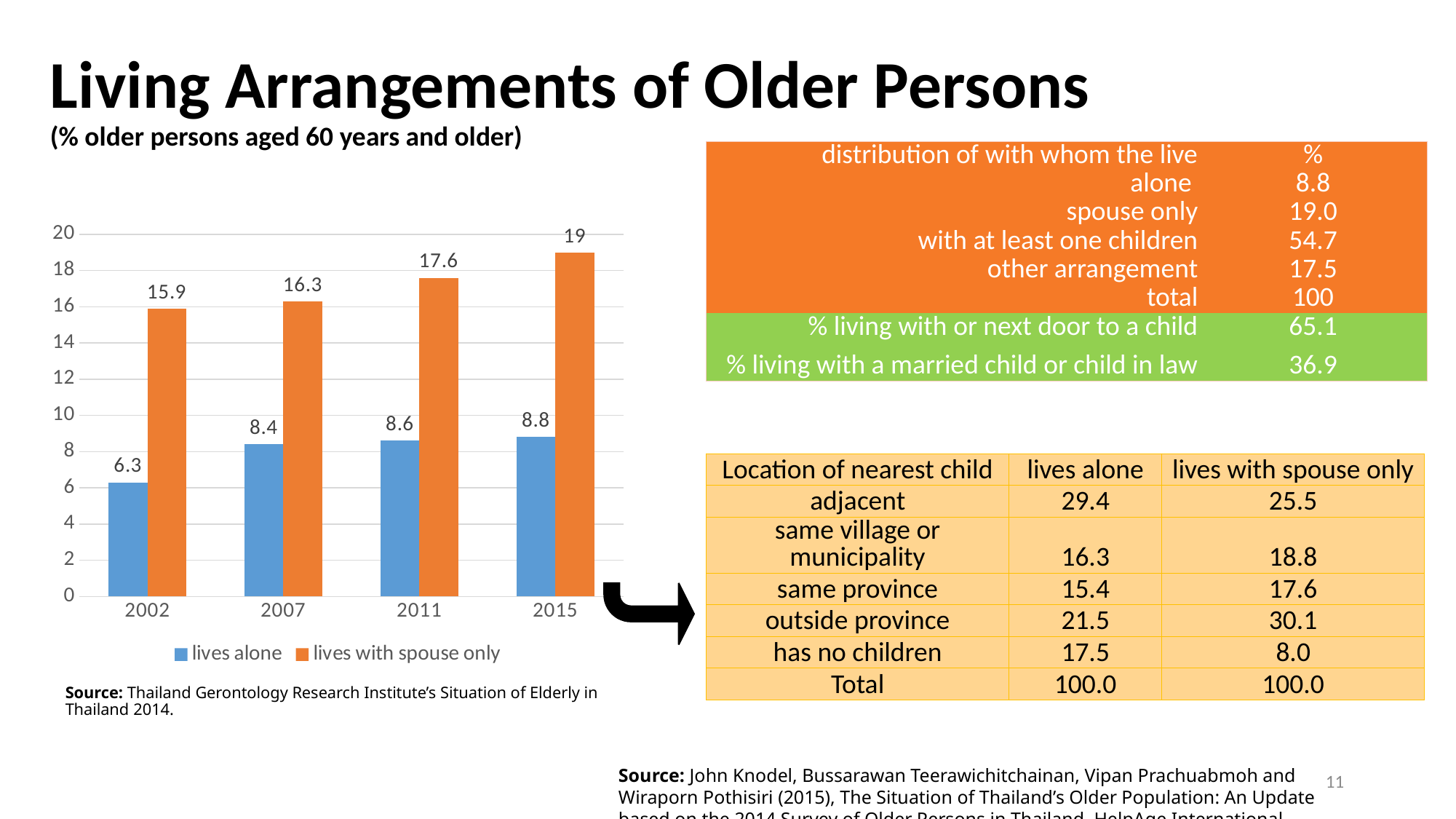
What is the difference between 'lives with spouse only' and 'lives alone' in 2015? 10.2 How many years are shown on the x axis of the chart? 4 How many series does the chart legend list? 2 What is the value for 'lives alone' in 2011? 8.6 What is the value for 'lives with spouse only' in 2015? 19 Does the 'lives alone' value rise or fall from 2002 to 2015? rise What kind of chart is shown on the slide? bar chart What is the value for 'lives alone' in 2002? 6.3 In which year is the 'lives alone' value lowest? 2002 What is the value for 'lives with spouse only' in 2007? 16.3 Which is larger in 2007: 'lives alone' or 'lives with spouse only'? lives with spouse only In which year is the 'lives with spouse only' value highest? 2015